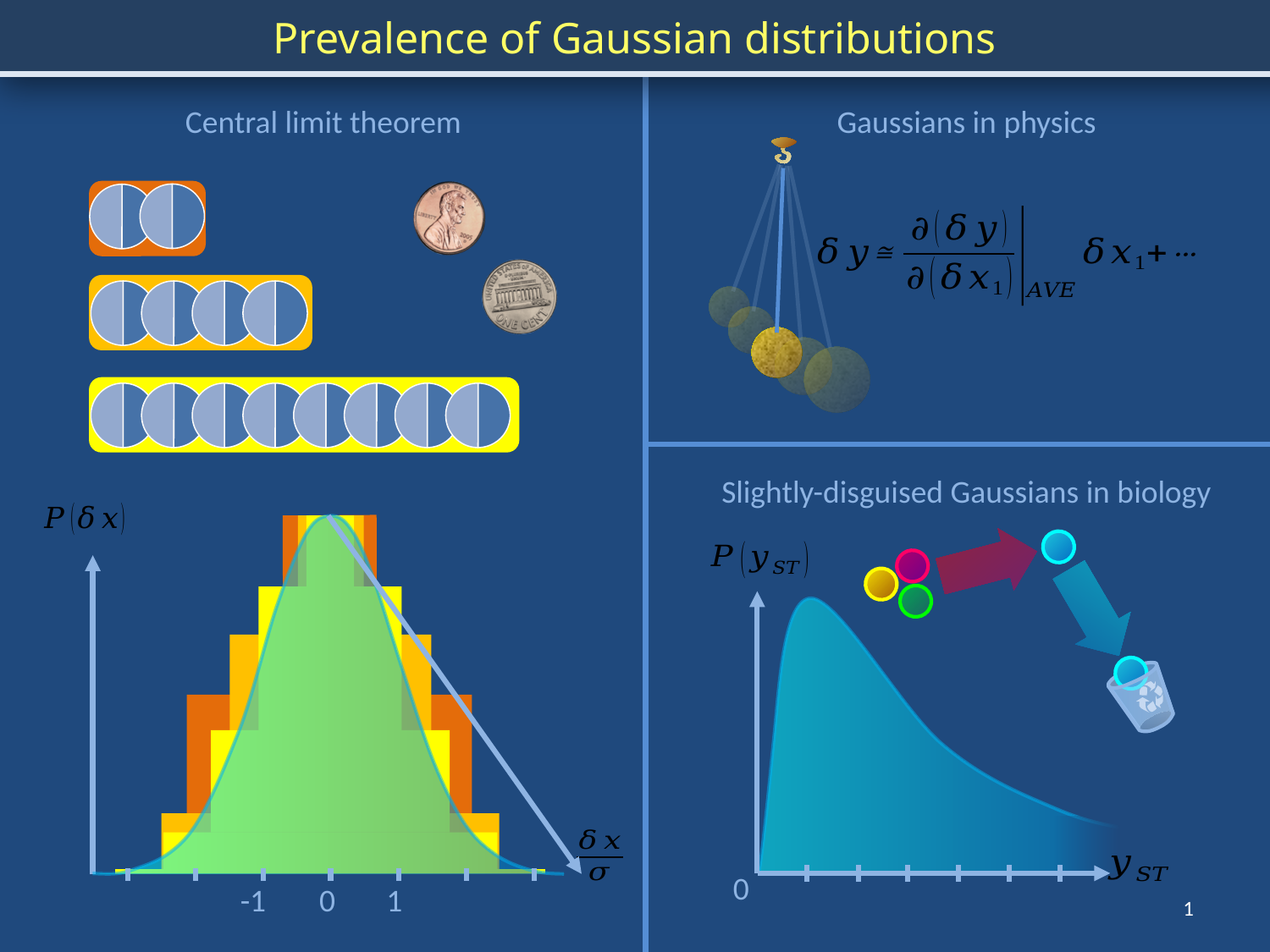
In the "Central limit theorem" chart, does the curve rise or fall as x goes from 0 to 1? Fall In the "Slightly-disguised Gaussians in biology" chart, does the curve rise or fall as y_ST increases past its peak? Fall In the "Central limit theorem" chart, which is taller: the histogram bar at 0 or the bar at 1? The bar at 0 What kind of chart is shown under "Central limit theorem"? A histogram with a bell curve overlaid In the "Slightly-disguised Gaussians in biology" chart, is the peak of the distribution closer to the left end or the right end of the x axis? Left end In the "Central limit theorem" chart, how many numeric tick labels are printed on the x axis? 3 What is the label on the y axis of the "Central limit theorem" chart? P(δx) What is the label on the x axis of the "Slightly-disguised Gaussians in biology" chart? y_ST In the "Central limit theorem" chart, at which x-axis value does the distribution reach its peak? 0 In the "Central limit theorem" chart, does the curve rise or fall as x goes from -1 to 0? Rise In the "Slightly-disguised Gaussians in biology" chart, what value is printed at the origin of the x axis? 0